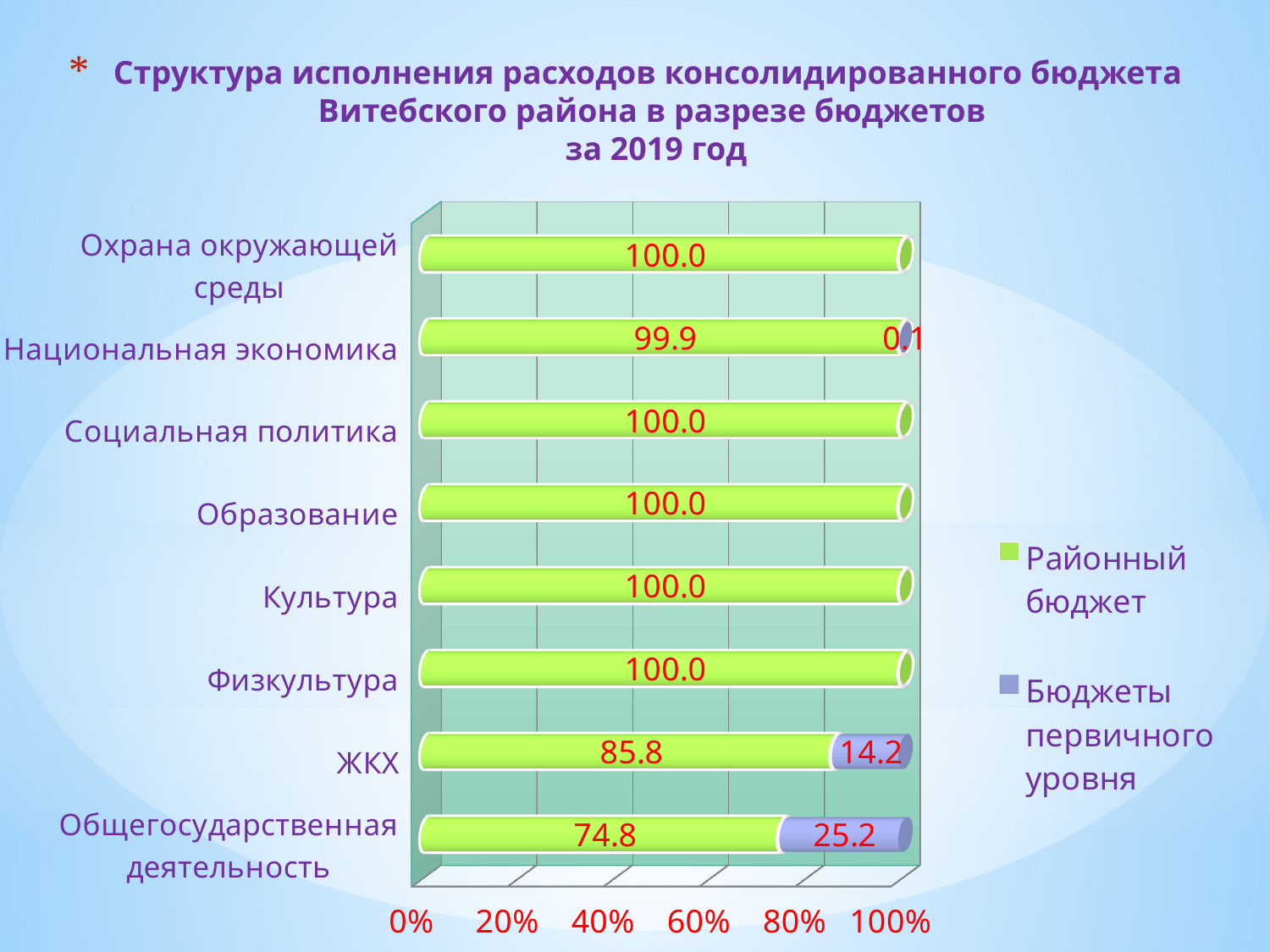
Which category has the lowest value for Районный бюджет? Общегосударственная деятельность What kind of chart is shown on the slide? bar chart How many categories are shown on the chart? 8 What is the difference between the Районный бюджет values for ЖКХ and Общегосударственная деятельность? 11.0 What is the value of Районный бюджет for ЖКХ? 85.8 Which is larger: the Бюджеты первичного уровня value for ЖКХ or for Национальная экономика? ЖКХ What is the value of Бюджеты первичного уровня for ЖКХ? 14.2 Which category has the highest value for Бюджеты первичного уровня? Общегосударственная деятельность What is the value of Районный бюджет for Национальная экономика? 99.9 How many series does the legend list? 2 What is the value of Бюджеты первичного уровня for Общегосударственная деятельность? 25.2 What is the total of the stacked bar for Общегосударственная деятельность? 100.0